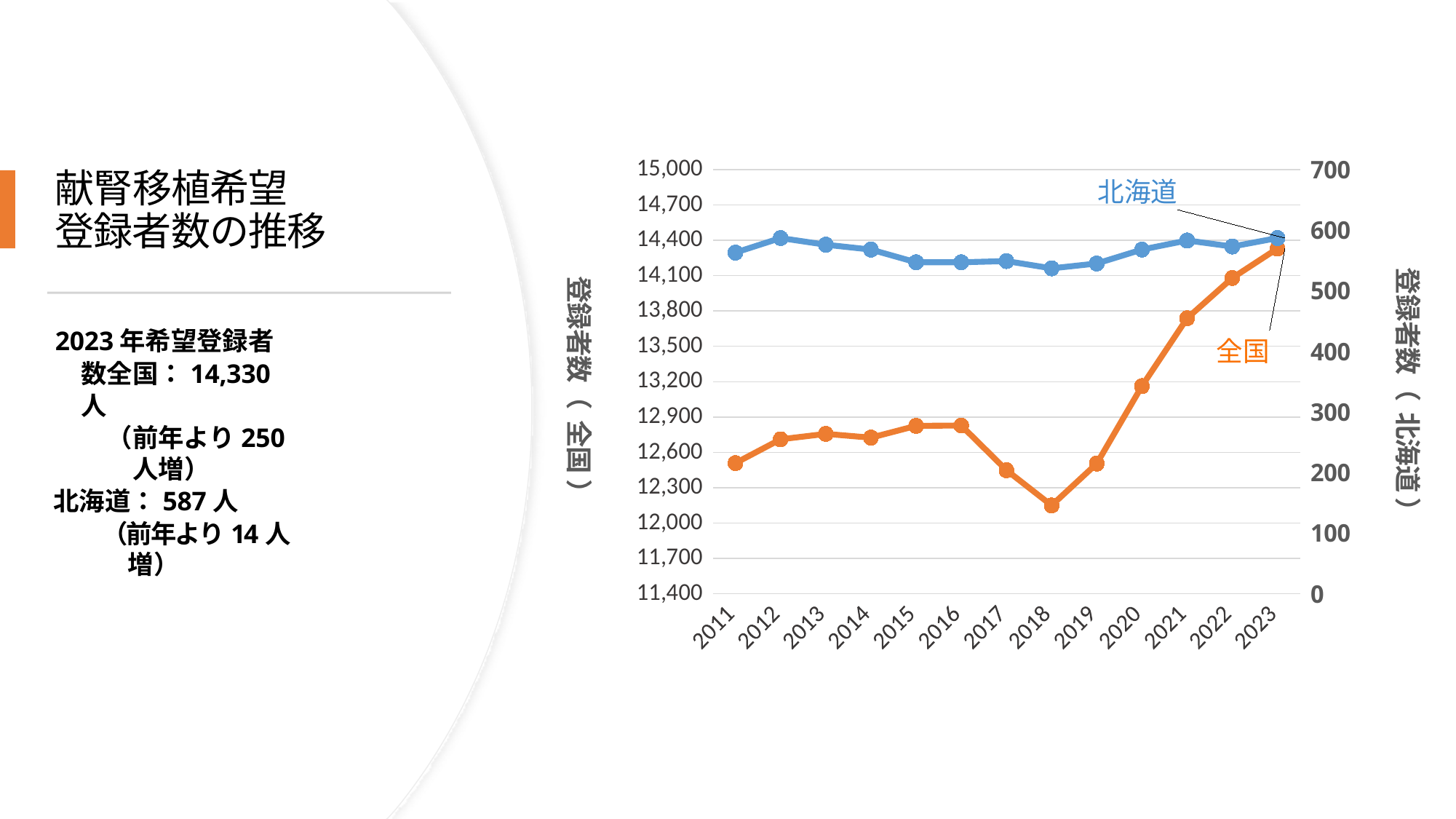
What is the 北海道 number of registrants in 2023? 587人 What is the 全国 (national) number of registrants in 2023? 14,330人 How many years are plotted along the x axis of the chart? 13 Is the 全国 value for 2018 greater or less than 12,300? less In which year is the 全国 series at its lowest? 2018 By how much did the 全国 number of registrants increase from 2022 to 2023? 250人 Which is larger for the 全国 series, the value in 2016 or the value in 2018? 2016 Does the 全国 series rise or fall from 2018 to 2023? rise How many series are plotted in the chart? 2 In which year is the 全国 series at its highest? 2023 Is the 全国 value for 2021 greater or less than 13,500? greater What kind of chart is shown on the slide? line chart